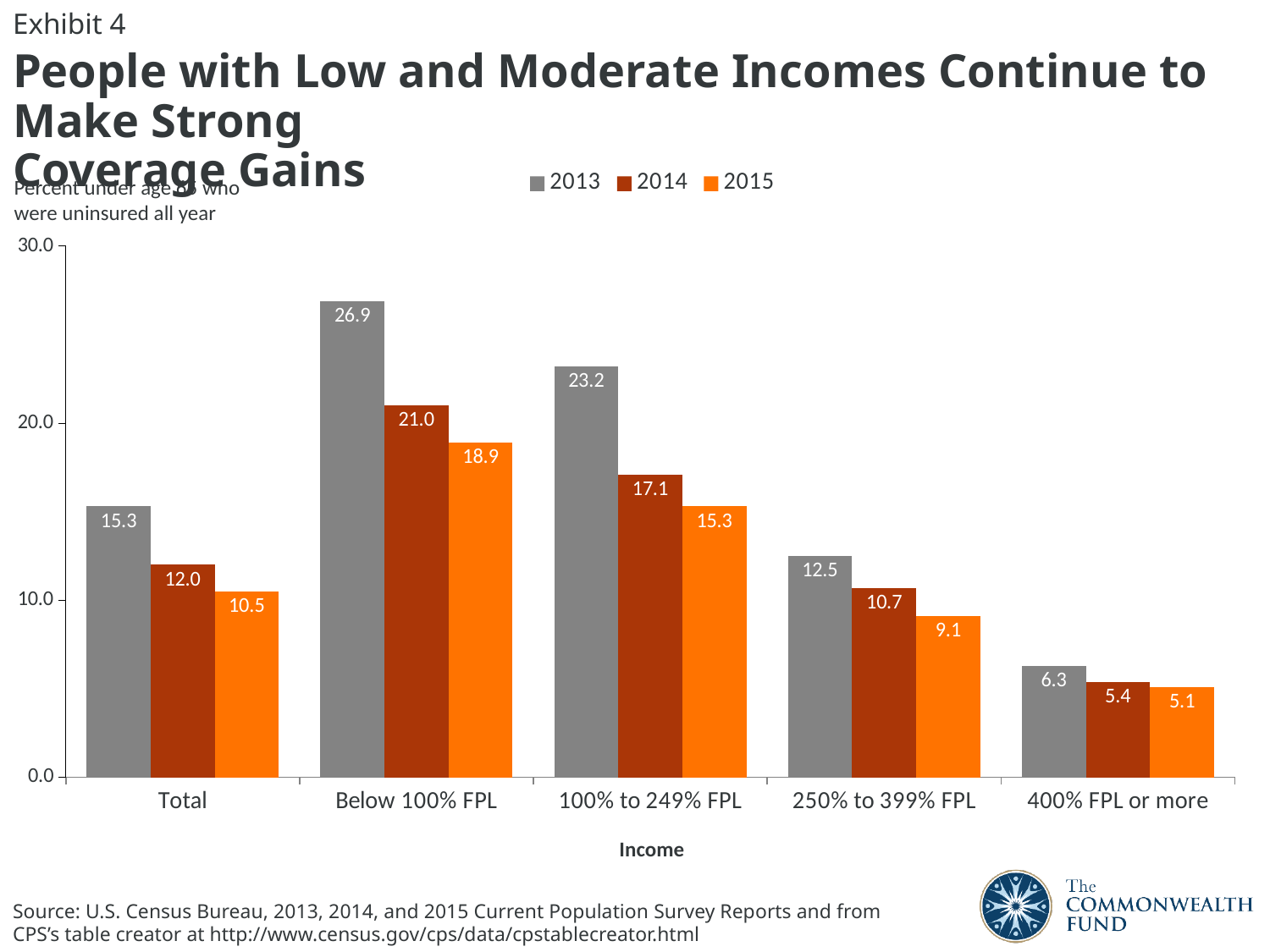
Within each income category, do the values rise or fall from 2013 to 2015? Fall How many income categories are shown on the x axis? 5 What kind of chart is shown on the slide? Bar chart Which is larger: the 2014 value for Below 100% FPL or the 2013 value for 100% to 249% FPL? 2013 value for 100% to 249% FPL Which income category has the lowest 2015 value? 400% FPL or more How many series does the legend list? 3 What is the 2014 value for 250% to 399% FPL? 10.7 Which income category has the highest 2013 value? Below 100% FPL What is the label of the x axis? Income What is the difference between the 2013 and 2015 values for 100% to 249% FPL? 7.9 What is the 2013 value for the Total category? 15.3 What is the 2015 value for Below 100% FPL? 18.9